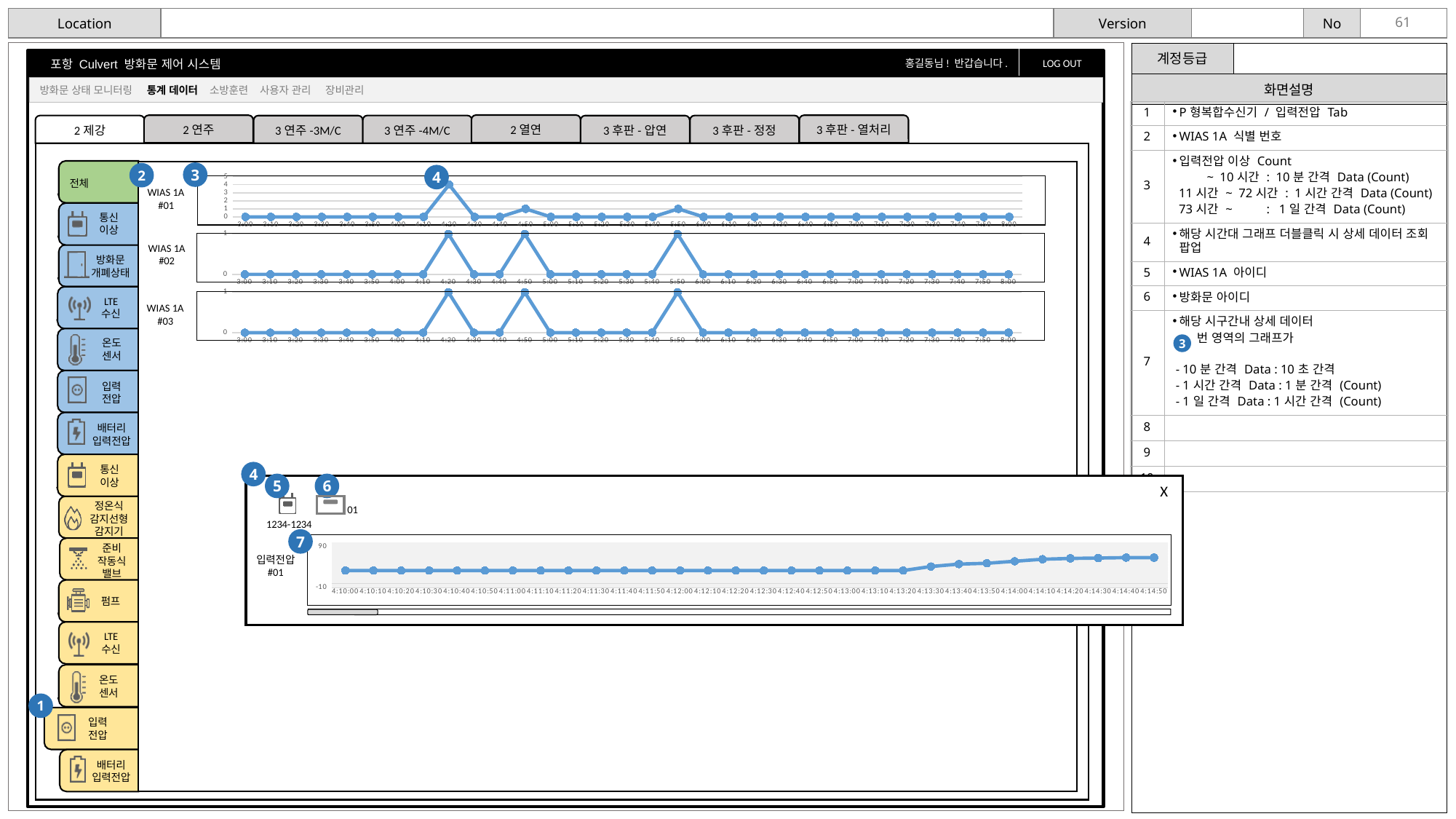
In the WIAS 1A #01 chart, which is larger, the value at 4:20 or the value at 4:50? 4:20 In the WIAS 1A #03 chart, how many times does the line reach 1? 3 What kind of chart is the WIAS 1A #01 chart? line chart In the WIAS 1A #01 chart, at which time is the value highest? 4:20 What is the highest y-axis label on the 입력전압 #01 chart in the popup? 90 In the 입력전압 #01 chart in the popup, is the value at 4:10:00 greater or less than 90? less In the WIAS 1A #01 chart, is the value at 4:20 greater or less than 3? greater In the 입력전압 #01 chart in the popup, do the values rise or fall toward the right end of the x axis? rise In the WIAS 1A #02 chart, what is the value at 3:00? 0 In the WIAS 1A #03 chart, is the value at 5:50 greater or less than 0? greater In the WIAS 1A #02 chart, what is the value at 4:20? 1 What is the first time label on the x axis of the WIAS 1A #01 chart? 3:00